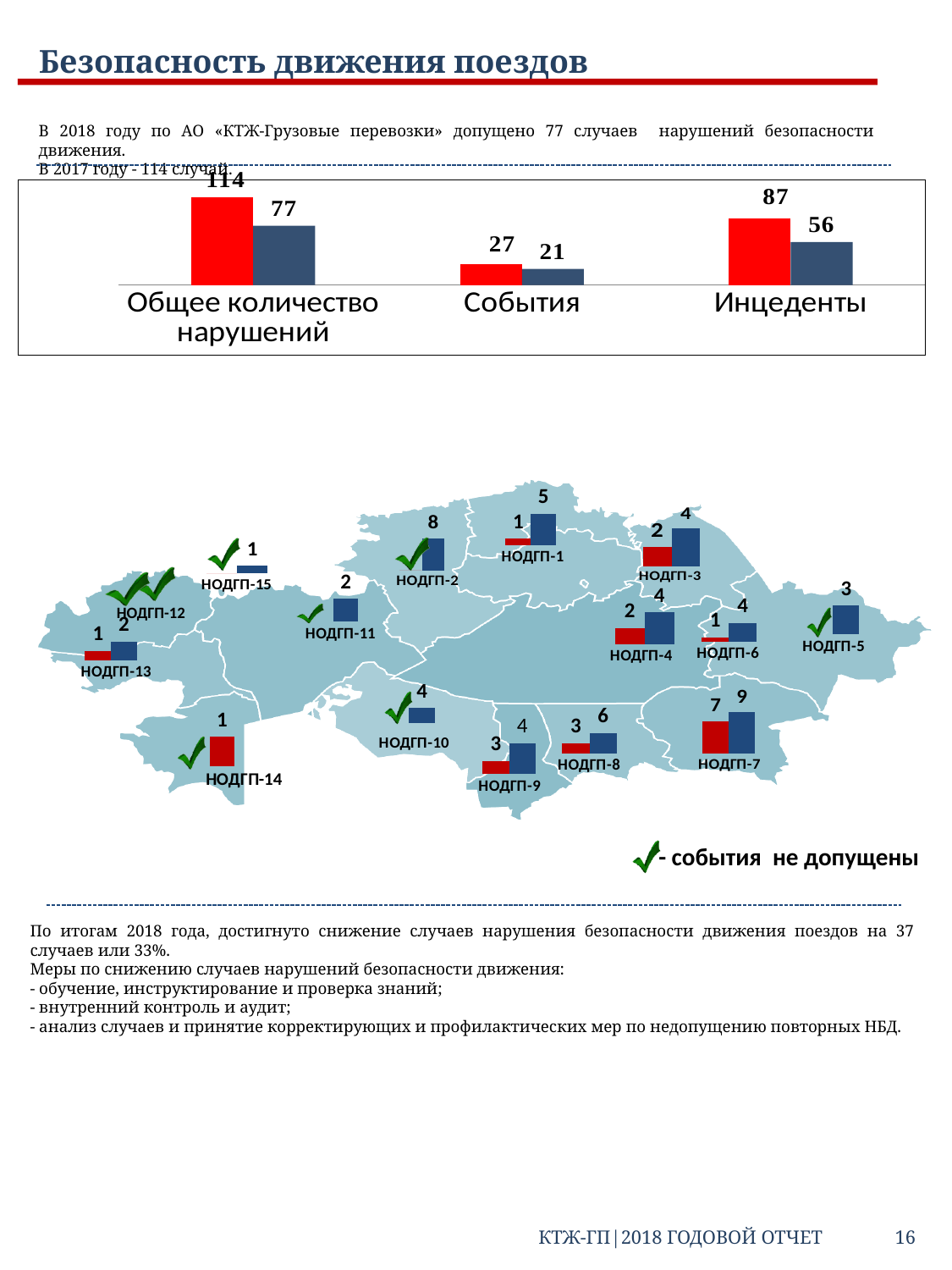
In the bar chart at the top of the slide, which category has the highest red bar? Общее количество нарушений In the bar chart at the top of the slide, what is the difference between the red and blue bars for «Инцеденты»? 31 In the bar chart at the top of the slide, what is the value of the red bar for «Общее количество нарушений»? 114 In the bar chart at the top of the slide, what is the value of the blue bar for «Инцеденты»? 56 In the bar chart at the top of the slide, what colour is the bar with the value 87? red How many categories are shown in the bar chart at the top of the slide? 3 In the bar chart at the top of the slide, what is the difference between the red and blue bars for «Общее количество нарушений»? 37 In the bar chart at the top of the slide, which category has the lowest values? События In the bar chart at the top of the slide, what is the value of the red bar for «События»? 27 In the bar chart at the top of the slide, which is larger for «События»: the red bar or the blue bar? the red bar What type of chart is shown at the top of the slide? bar chart In the bar chart at the top of the slide, what is the value of the blue bar for «Общее количество нарушений»? 77